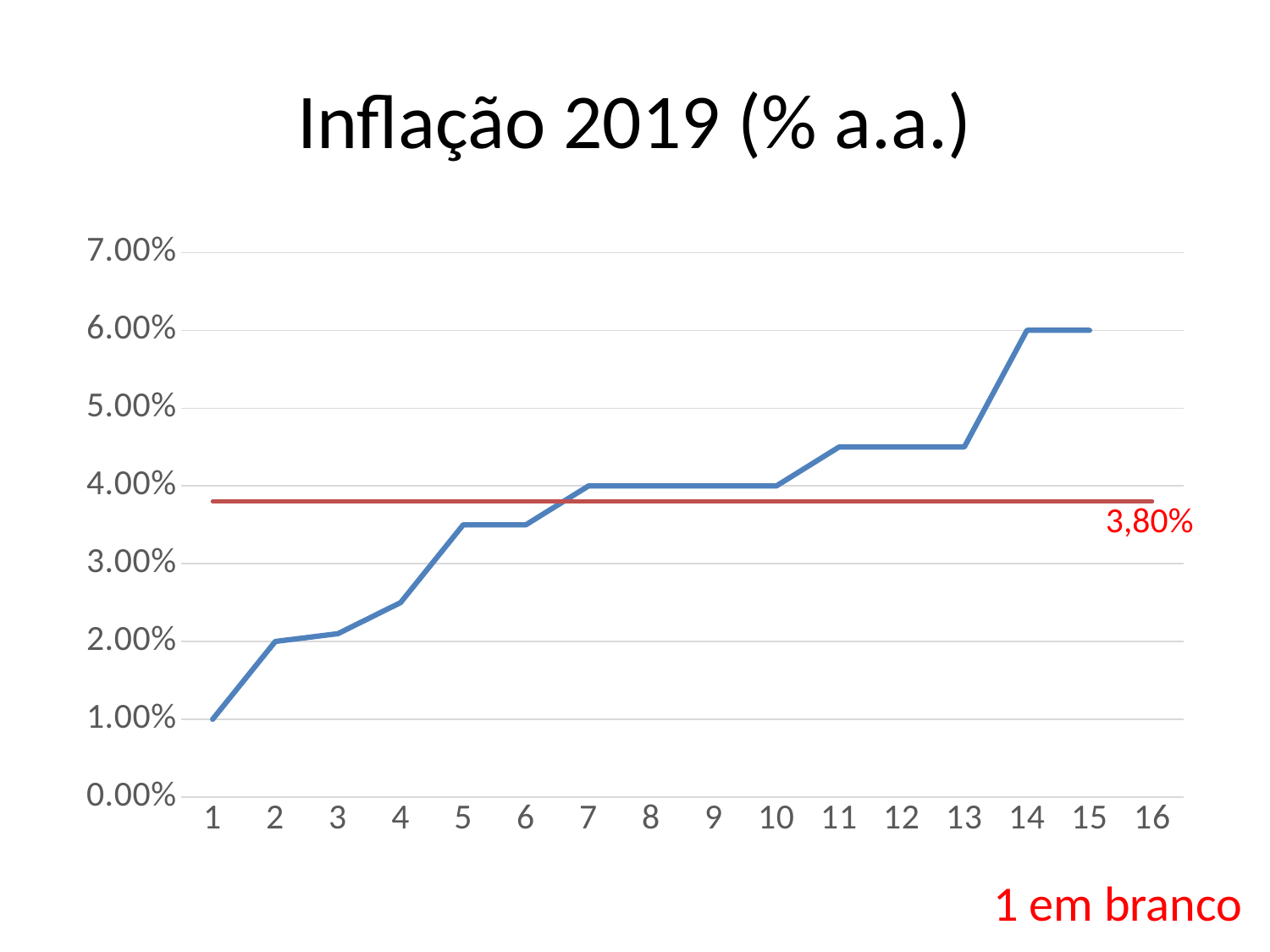
What is the difference between the blue line's value at x = 14 and at x = 1? 5.00% At which x value is the blue line lowest? 1 Is the value of the blue line at x = 4 greater or less than 3.00%? less What kind of chart is shown on the slide? line chart What is the value of the blue line at x = 7? 4.00% Is the value of the blue line at x = 5 greater or less than 3.00%? greater Is the value of the blue line at x = 11 greater or less than 4.00%? greater What is the value of the blue line at x = 1? 1.00% What value is labelled on the red horizontal line? 3,80% What is the title of the chart? Inflação 2019 (% a.a.) Does the blue line generally rise or fall from x = 1 to x = 15? rise What is the value of the blue line at x = 14? 6.00%